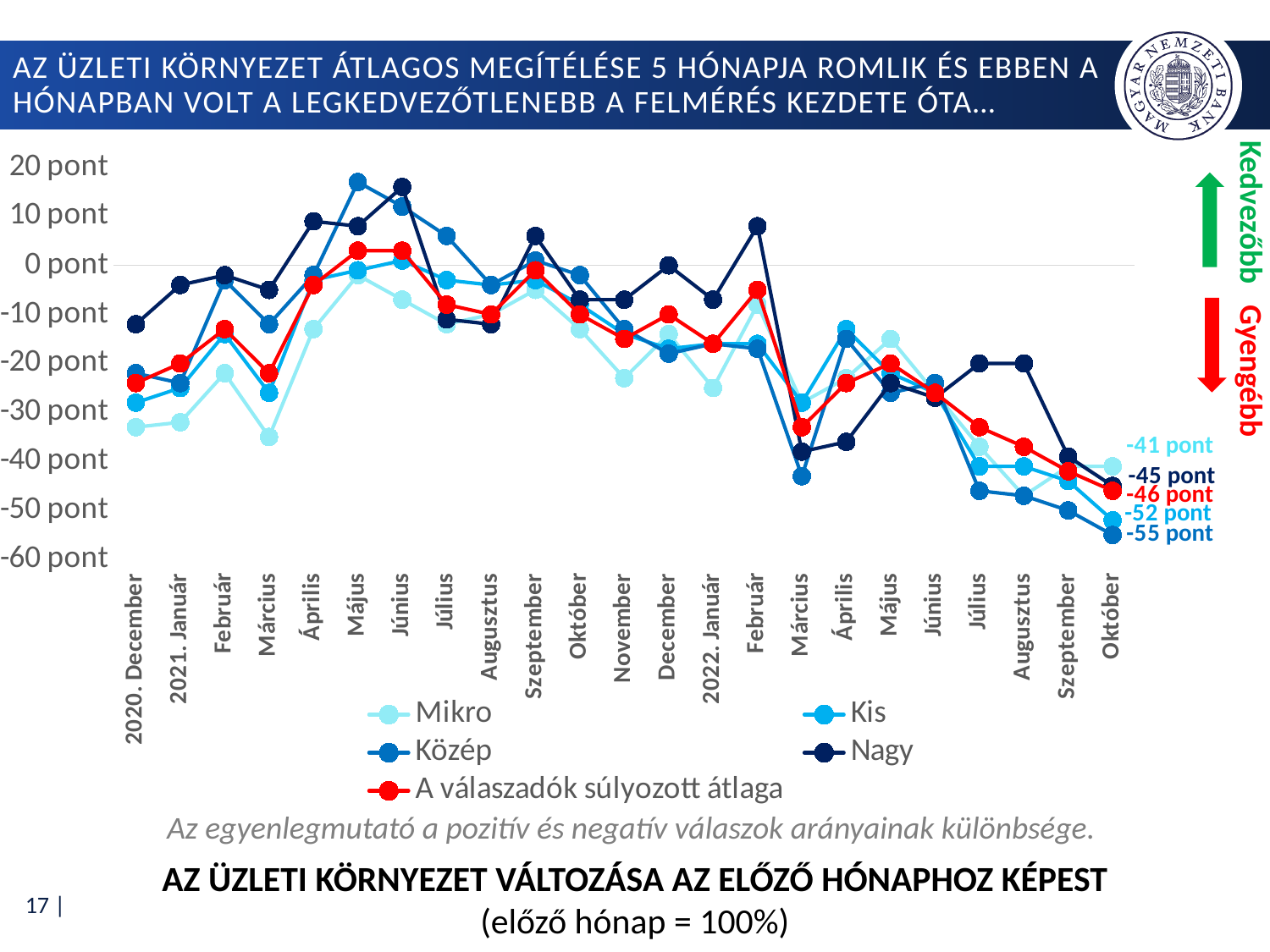
Which series has the highest value in Október (2022)? Mikro What kind of chart is shown on the slide? line chart Which series has the lowest value in Október (2022)? Közép What is the value for Közép in Október (2022)? -55 pont How many series does the legend list? 5 What is the value for Mikro in Október (2022)? -41 pont What is the difference between the Mikro and Közép values in Október (2022)? 14 pont Is the value for Közép in Május (2021) greater or less than 10 pont? greater What is the value of 'A válaszadók súlyozott átlaga' in Október (2022)? -46 pont In Október (2022), which is higher: Nagy or Kis? Nagy What is the value for Kis in Október (2022)? -52 pont Does the weighted average series ('A válaszadók súlyozott átlaga') rise or fall from 2022 Február to Október? fall